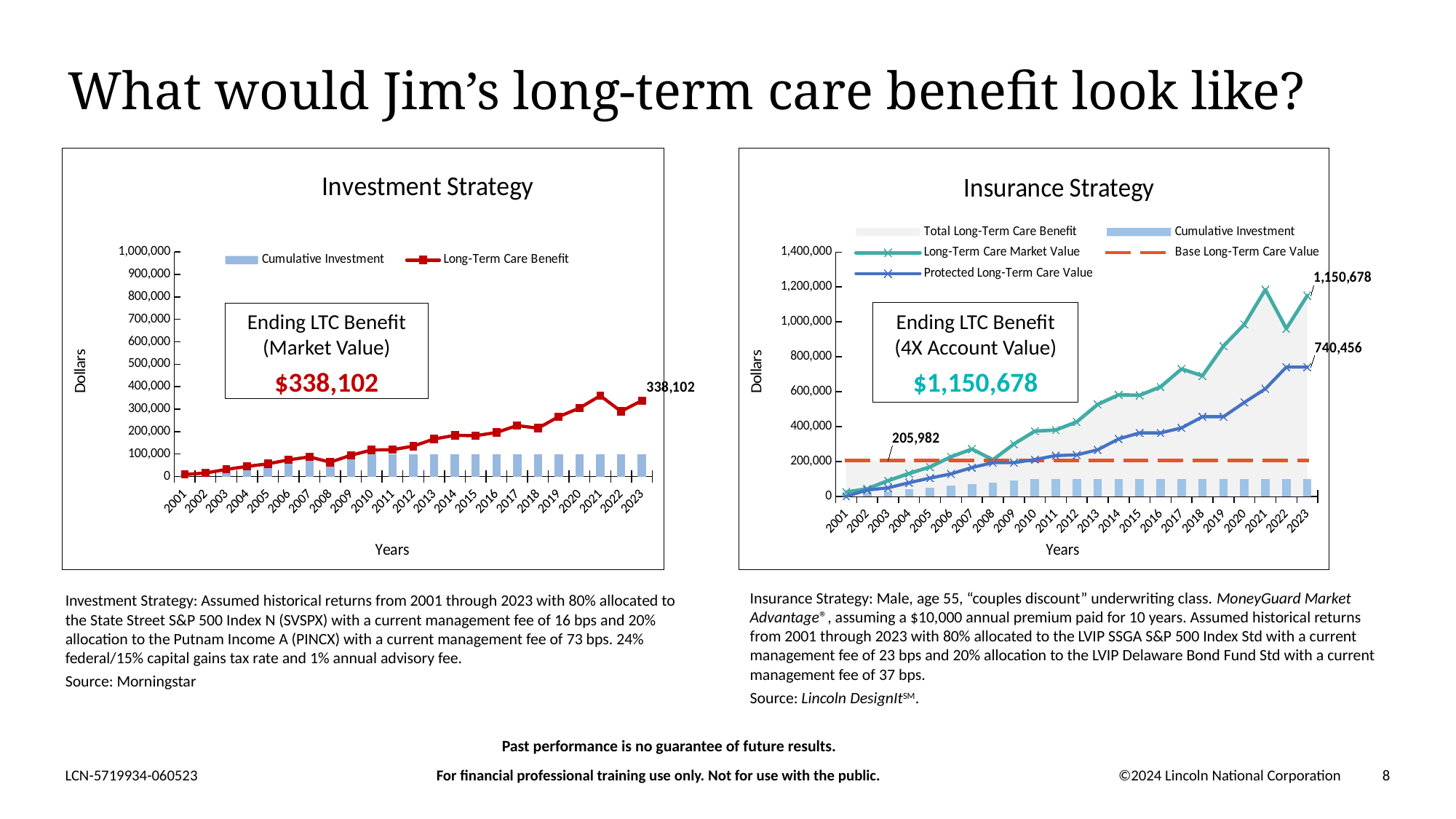
How much larger is the 2023 Long-Term Care Market Value in the Insurance Strategy chart than the 2023 Long-Term Care Benefit in the Investment Strategy chart? 812,576 How many years are shown on the x axis of the Investment Strategy chart? 23 In the Investment Strategy chart, is the Long-Term Care Benefit for 2021 greater or less than 300,000? greater In the Insurance Strategy chart, what is the Protected Long-Term Care Value labeled for 2023? 740,456 How many series does the legend of the Insurance Strategy chart list? 5 In the Investment Strategy chart, what is the Long-Term Care Benefit value labeled for 2023? 338,102 In the Insurance Strategy chart, what is the difference between the 2023 Long-Term Care Market Value and the 2023 Protected Long-Term Care Value? 410,222 In the Insurance Strategy chart, which is larger in 2023: the Long-Term Care Market Value or the Protected Long-Term Care Value? Long-Term Care Market Value In the Investment Strategy chart, which year has the highest Long-Term Care Benefit? 2021 In the Insurance Strategy chart, what is the Long-Term Care Market Value labeled for 2023? 1,150,678 What is the y-axis title of the Investment Strategy chart? Dollars In the Insurance Strategy chart, what value is labeled on the Base Long-Term Care Value line? 205,982